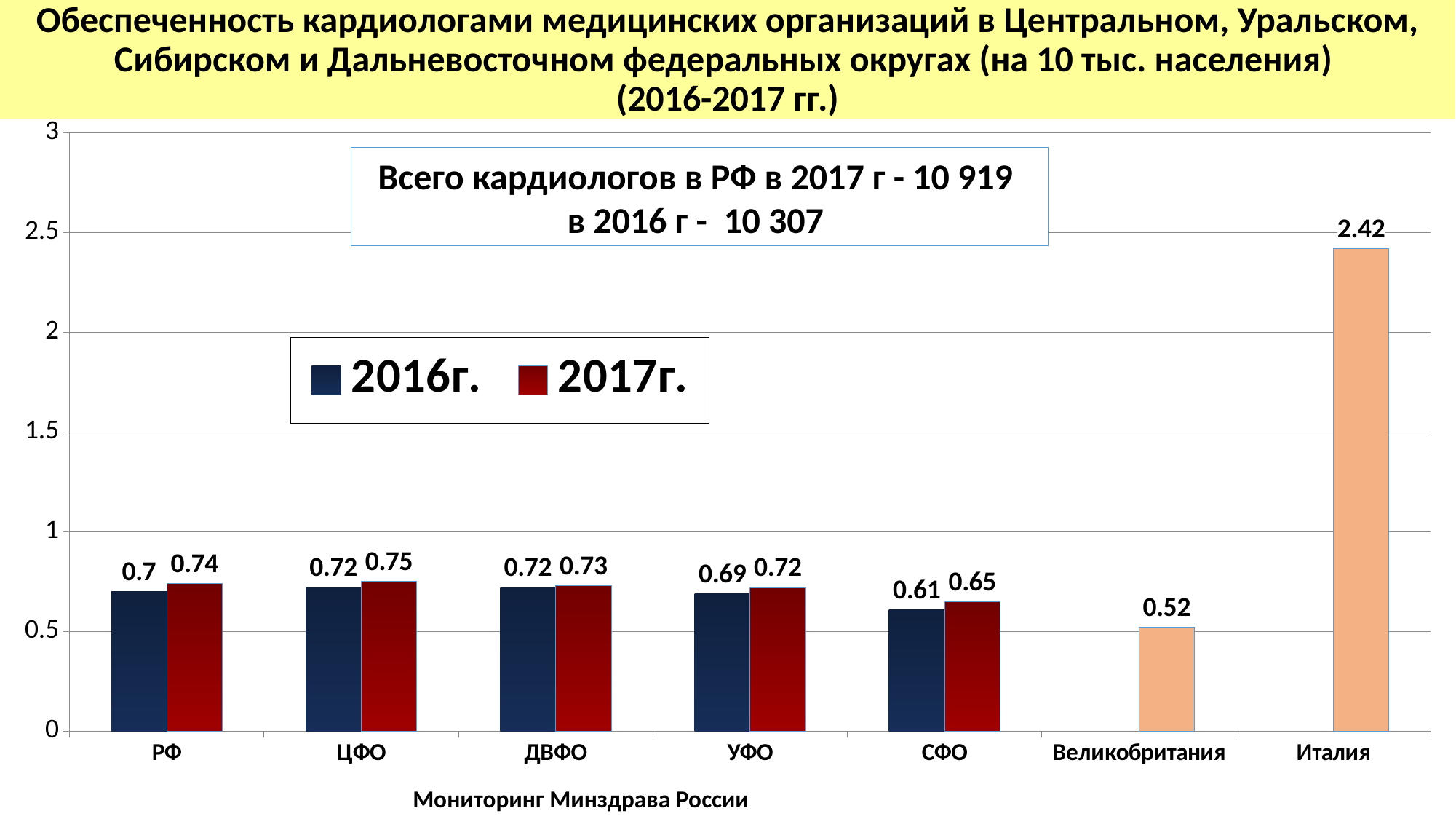
What is the value for РФ in 2017г.? 0.74 What is the value shown for Италия? 2.42 What is the value for СФО in 2016г.? 0.61 Which is larger: the 2017г. value for ЦФО or the 2017г. value for СФО? ЦФО What is the difference between the 2017г. and 2016г. values for УФО? 0.03 How many series does the legend list? 2 Which category has the highest value on the chart? Италия How many categories are shown on the x axis? 7 What kind of chart is shown on the slide? bar chart Is the value for Италия greater or less than 2? greater Which category has the lowest value on the chart? Великобритания What is the value shown for Великобритания? 0.52